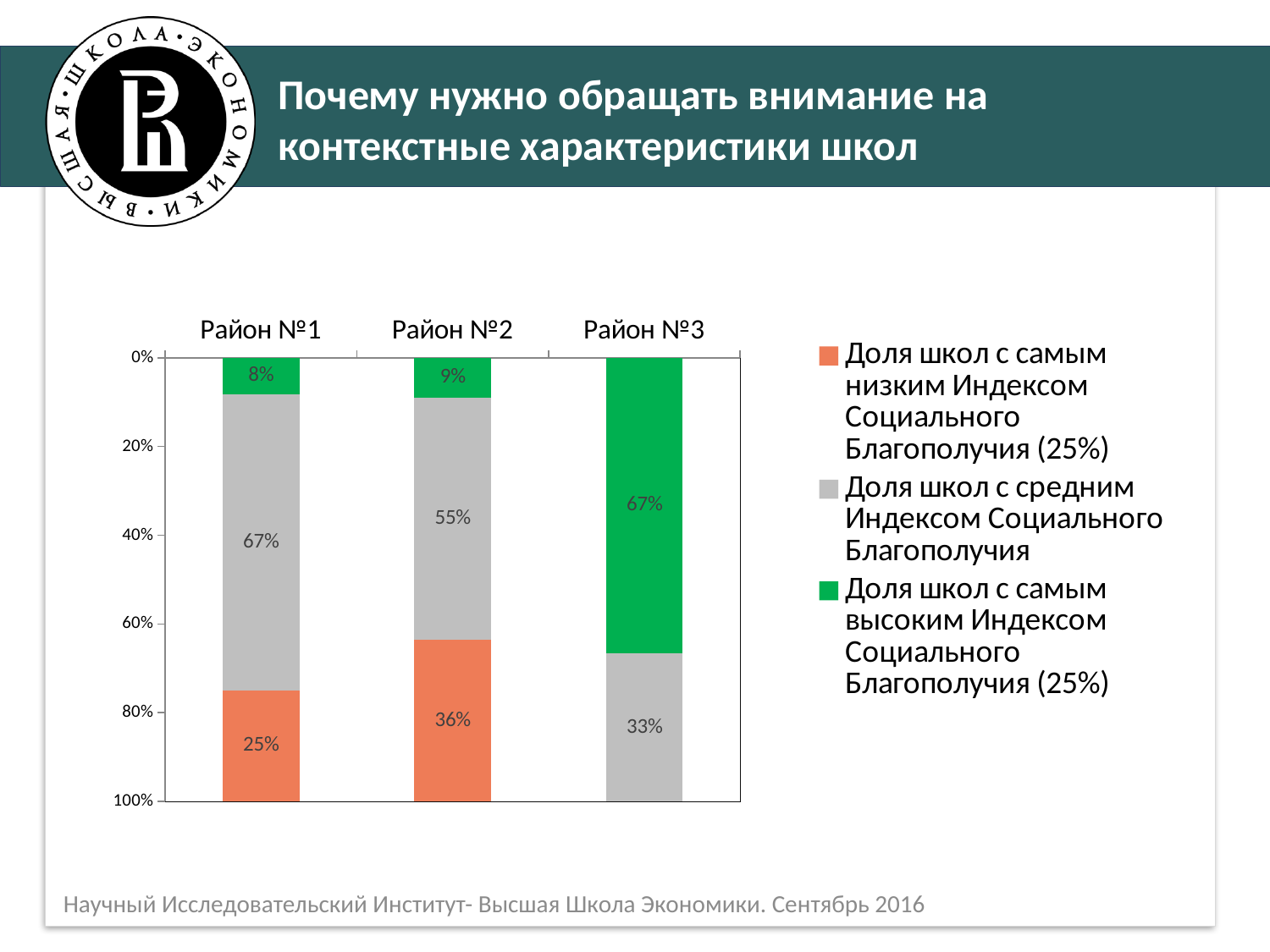
How many districts are shown on the chart? 3 How many series does the legend list? 3 What is the difference between the share of schools with the lowest index in Район №2 and in Район №1? 11% What share of schools in Район №2 have the lowest Social Well-being Index (orange segment)? 36% What colour represents the share of schools with the lowest Social Well-being Index? Orange Which district has the largest share of schools with the highest Social Well-being Index (green segment)? Район №3 Which district has the smallest share of schools with the highest Social Well-being Index (green segment)? Район №1 What share of schools in Район №2 have the middle Social Well-being Index (grey segment)? 55% What share of schools in Район №1 have the lowest Social Well-being Index (orange segment)? 25% Which is larger: the share of schools with the middle index in Район №1 or in Район №2? Район №1 What share of schools in Район №3 have the highest Social Well-being Index (green segment)? 67% What kind of chart is shown on the slide? Stacked bar chart